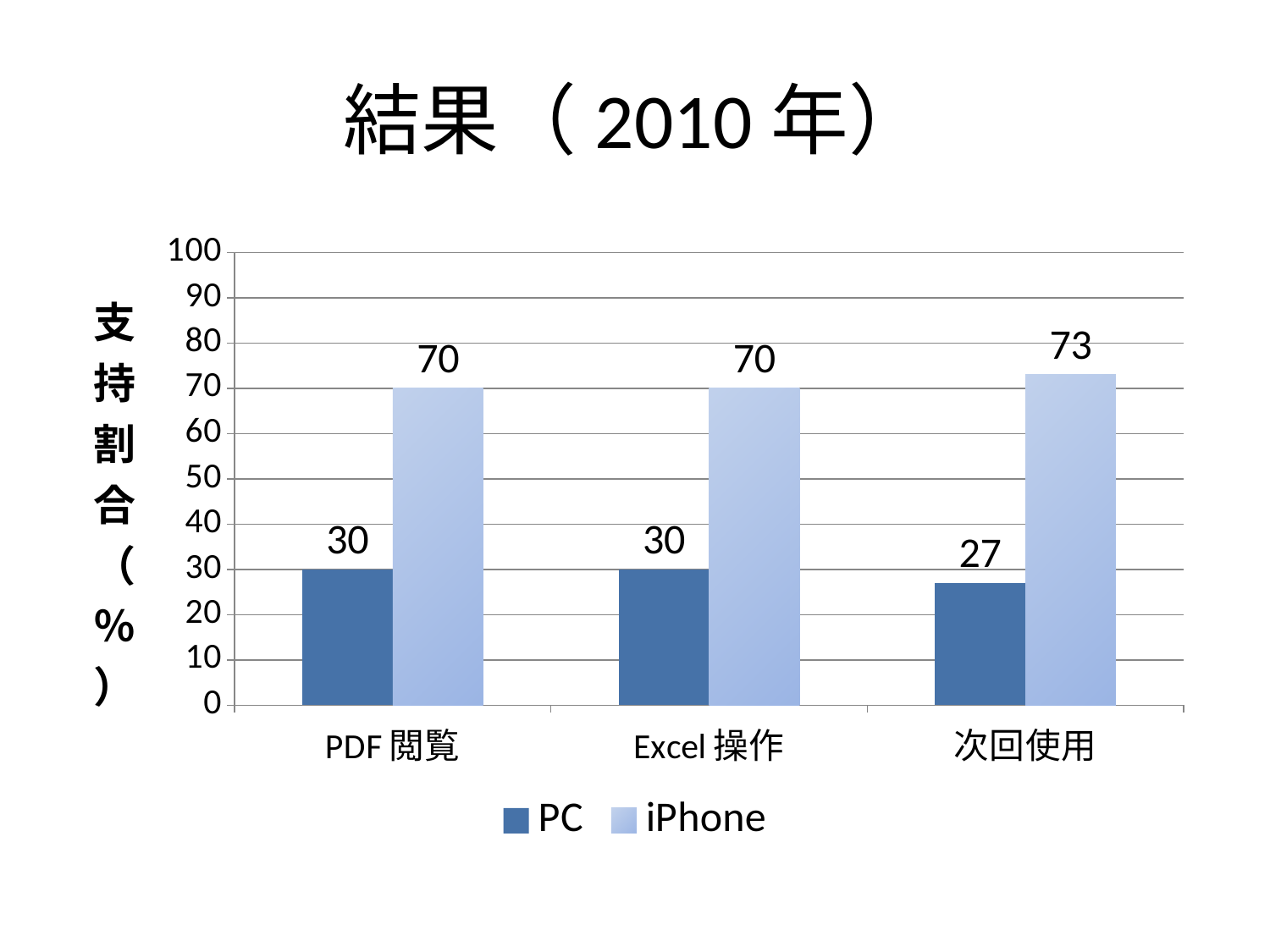
What is the value for PC in the PDF閲覧 category? 30 What is the title of the slide? 結果（2010年） What is the value for iPhone in the Excel操作 category? 70 What is the value for PC in the 次回使用 category? 27 What is the value for iPhone in the 次回使用 category? 73 In which category is the PC value lowest? 次回使用 How many series does the legend list? 2 What kind of chart is shown on the slide? Bar chart What is the difference between the iPhone and PC values in the 次回使用 category? 46 In which category is the iPhone value highest? 次回使用 How many categories are shown on the x axis? 3 Which is larger in the PDF閲覧 category, the PC value or the iPhone value? iPhone